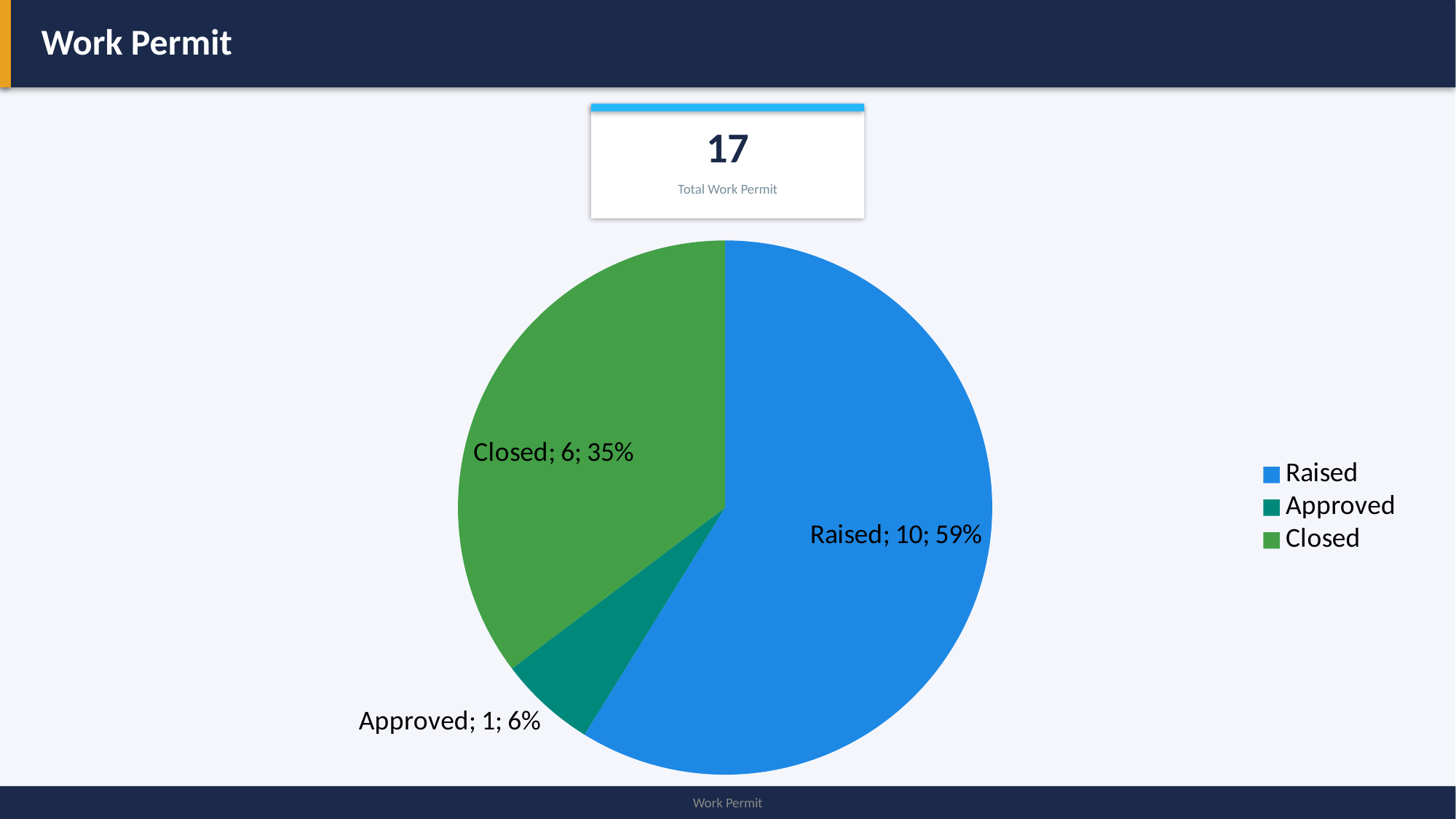
What is the value for Closed? 6 Which is larger, the value for Closed or the value for Approved? Closed Which category has the smallest slice? Approved What share of the pie does Raised represent? 59% What kind of chart is shown on the slide? pie chart What is the value for Approved? 1 How many slices does the pie chart have? 3 Which category has the largest slice? Raised What is the value for Raised? 10 What share of the pie does Closed represent? 35% How many entries does the legend list? 3 What is the difference between the values for Raised and Closed? 4